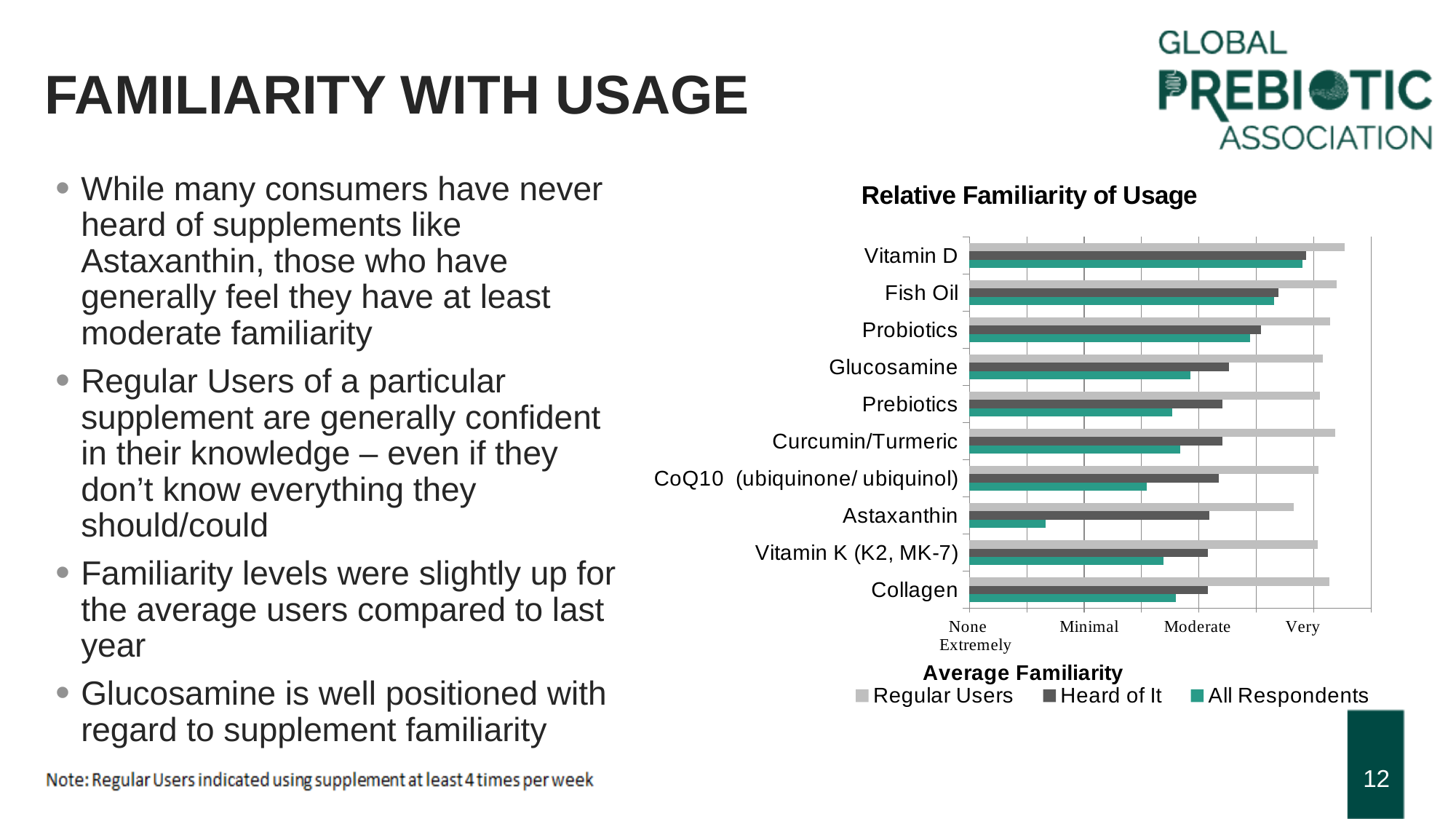
How many supplement categories are plotted in the chart? 10 What is the title of the chart? Relative Familiarity of Usage For Regular Users, which is higher: Astaxanthin or Collagen? Collagen What is the label on the chart's horizontal axis? Average Familiarity Which supplement has the lowest Regular Users familiarity? Astaxanthin For Heard of It, which is higher: Fish Oil or Glucosamine? Fish Oil Which supplement has the highest Heard of It familiarity? Vitamin D Which supplement has the highest All Respondents familiarity? Vitamin D Which supplement has the lowest All Respondents familiarity? Astaxanthin What kind of chart is shown on the slide? Bar chart How many series does the chart legend list? 3 For All Respondents, which is higher: Fish Oil or Prebiotics? Fish Oil